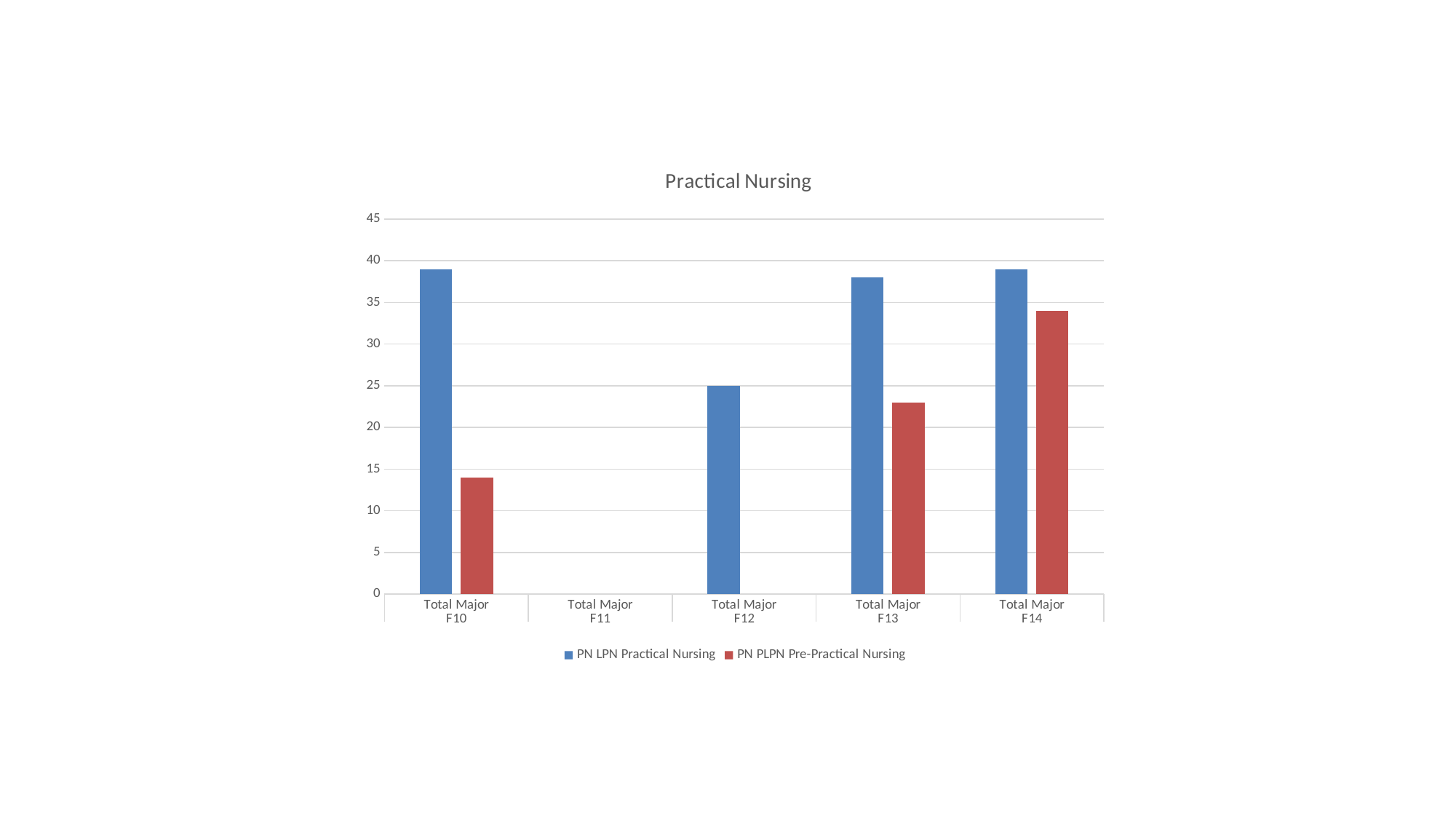
Is the value for PN LPN Practical Nursing at Total Major F10 greater or less than 35? greater What type of chart is shown on the slide? bar chart Among the categories where it is plotted, which has the lowest value for PN LPN Practical Nursing? Total Major F12 What is the value for PN LPN Practical Nursing at Total Major F12? 25 How many series does the legend list? 2 Which category has the highest value for PN PLPN Pre-Practical Nursing? Total Major F14 At Total Major F13, which series has the larger value, PN LPN Practical Nursing or PN PLPN Pre-Practical Nursing? PN LPN Practical Nursing What is the title of the chart? Practical Nursing How many categories are shown on the x axis? 5 Is the value for PN PLPN Pre-Practical Nursing at Total Major F14 greater or less than 30? greater Is the value for PN PLPN Pre-Practical Nursing at Total Major F10 greater or less than 15? less Which category has no bars plotted? Total Major F11